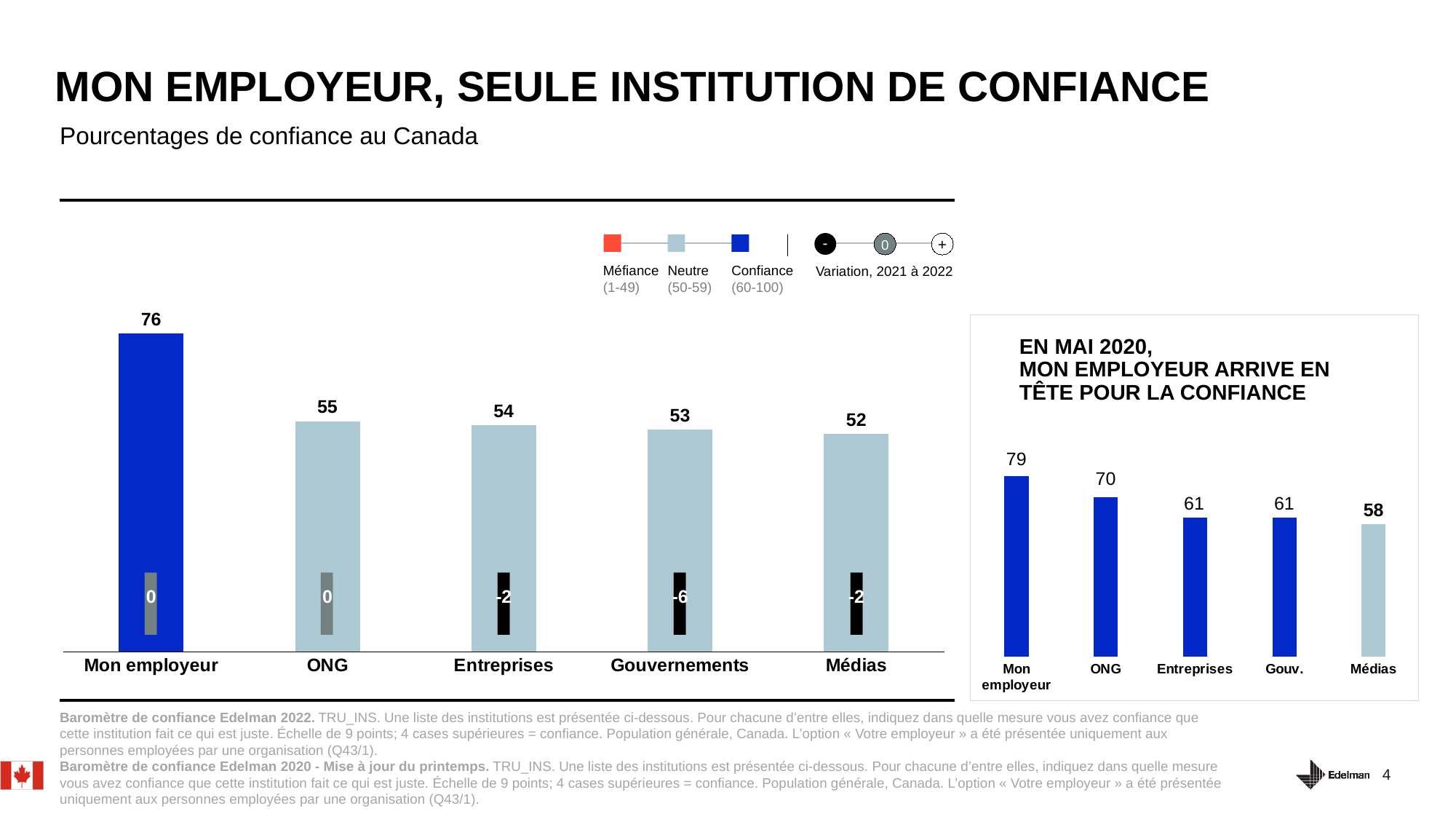
In the main chart on the left, what is the value for Gouvernements? 53 In the main chart on the left, how many institutions are plotted? 5 In the main chart on the left, which institution has the lowest trust percentage? Médias In the chart on the right titled 'En mai 2020, mon employeur arrive en tête pour la confiance', what is the value for Médias? 58 In the main chart on the left, what is the trust percentage for Mon employeur? 76 In the main chart on the left, what is the difference between the values for Mon employeur and ONG? 21 In the main chart on the left, which colour is used for the Mon employeur bar, indicating the 'Confiance (60-100)' category? Blue In the chart on the right titled 'En mai 2020, mon employeur arrive en tête pour la confiance', what is the value for ONG? 70 In the chart on the right titled 'En mai 2020, mon employeur arrive en tête pour la confiance', what is the difference between Mon employeur and Entreprises? 18 In the main chart on the left, which institution has the highest trust percentage? Mon employeur In the main chart on the left, what is the variation from 2021 to 2022 shown for Gouvernements? -6 What type of chart is the main chart on the left? Bar chart